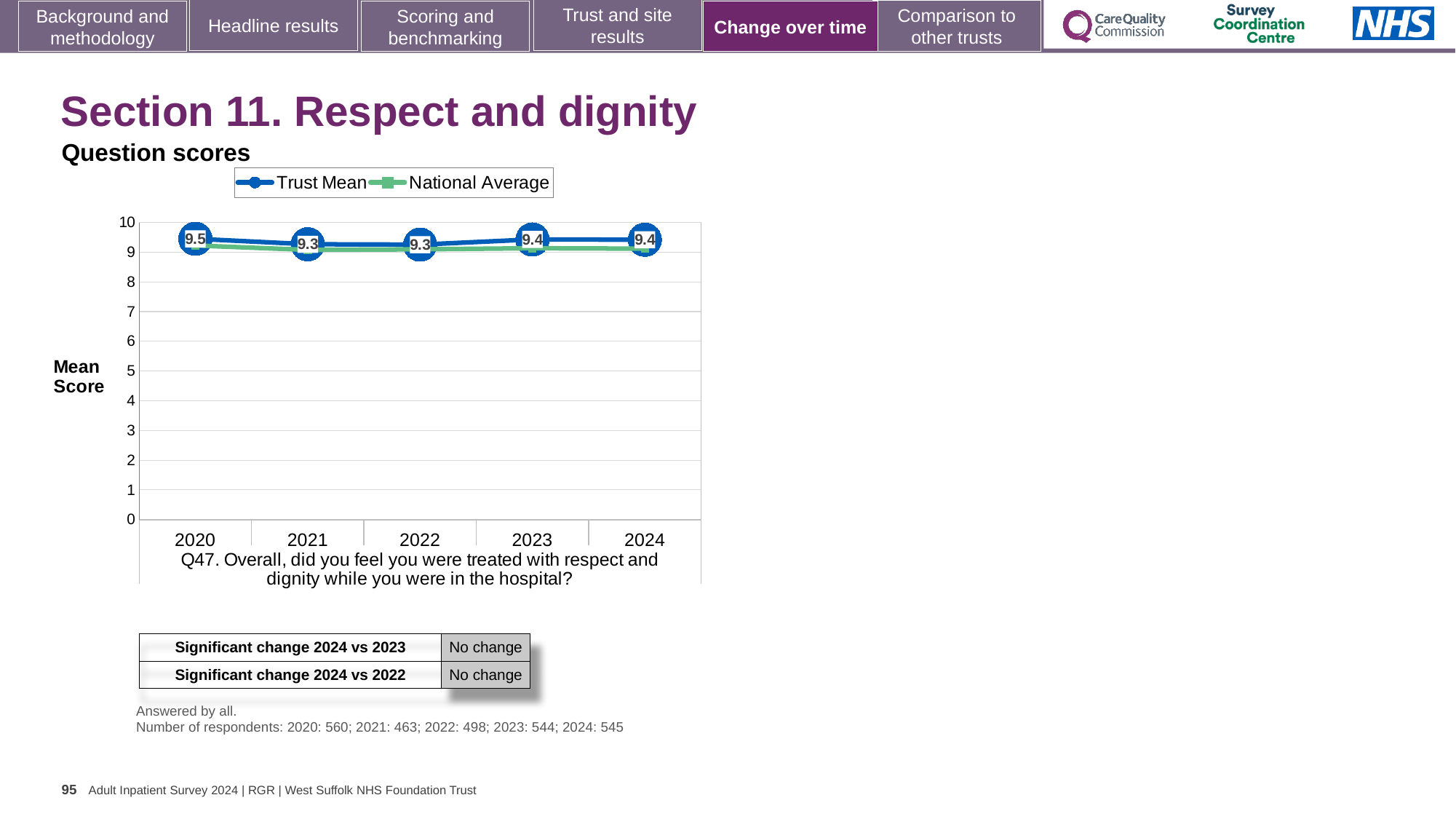
What is the Trust Mean score for 2020? 9.5 How many series does the legend list? 2 What is the Trust Mean score for 2024? 9.4 Is the National Average value for 2024 greater or less than 8? greater What kind of chart is shown on the slide? Line chart Does the Trust Mean score rise or fall from 2020 to 2021? fall What is the difference between the Trust Mean scores for 2020 and 2021? 0.2 Which is larger, the Trust Mean score for 2020 or for 2023? 2020 What is the Trust Mean score for 2022? 9.3 In which year is the Trust Mean score highest? 2020 What is the label on the y axis of the chart? Mean Score How many years are plotted on the x axis? 5